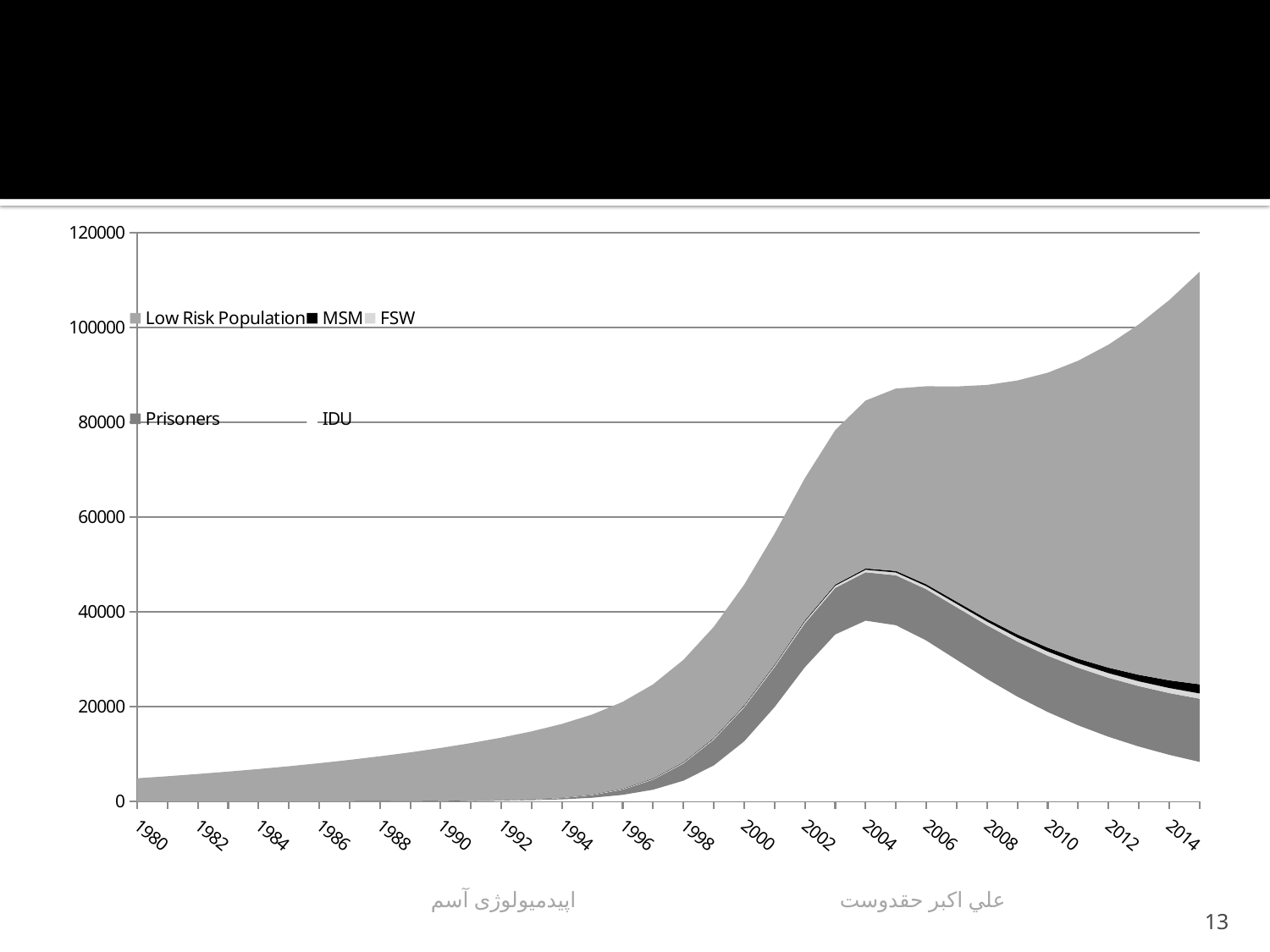
What is the highest value shown on the vertical axis? 120000 Is the total stacked value in 2010 greater or less than 100000? less Is the total stacked value in 2014 greater or less than 100000? greater Is the total stacked value larger in 2014 or in 1990? 2014 Is the total stacked value in 1998 greater or less than 40000? less How many series does the legend list? 5 How many year labels are shown along the x axis? 18 Does the total stacked value rise or fall from 1980 to 2014? rise What kind of chart is shown on the slide? Area chart Which series are listed in the chart legend? Low Risk Population, MSM, FSW, Prisoners, IDU